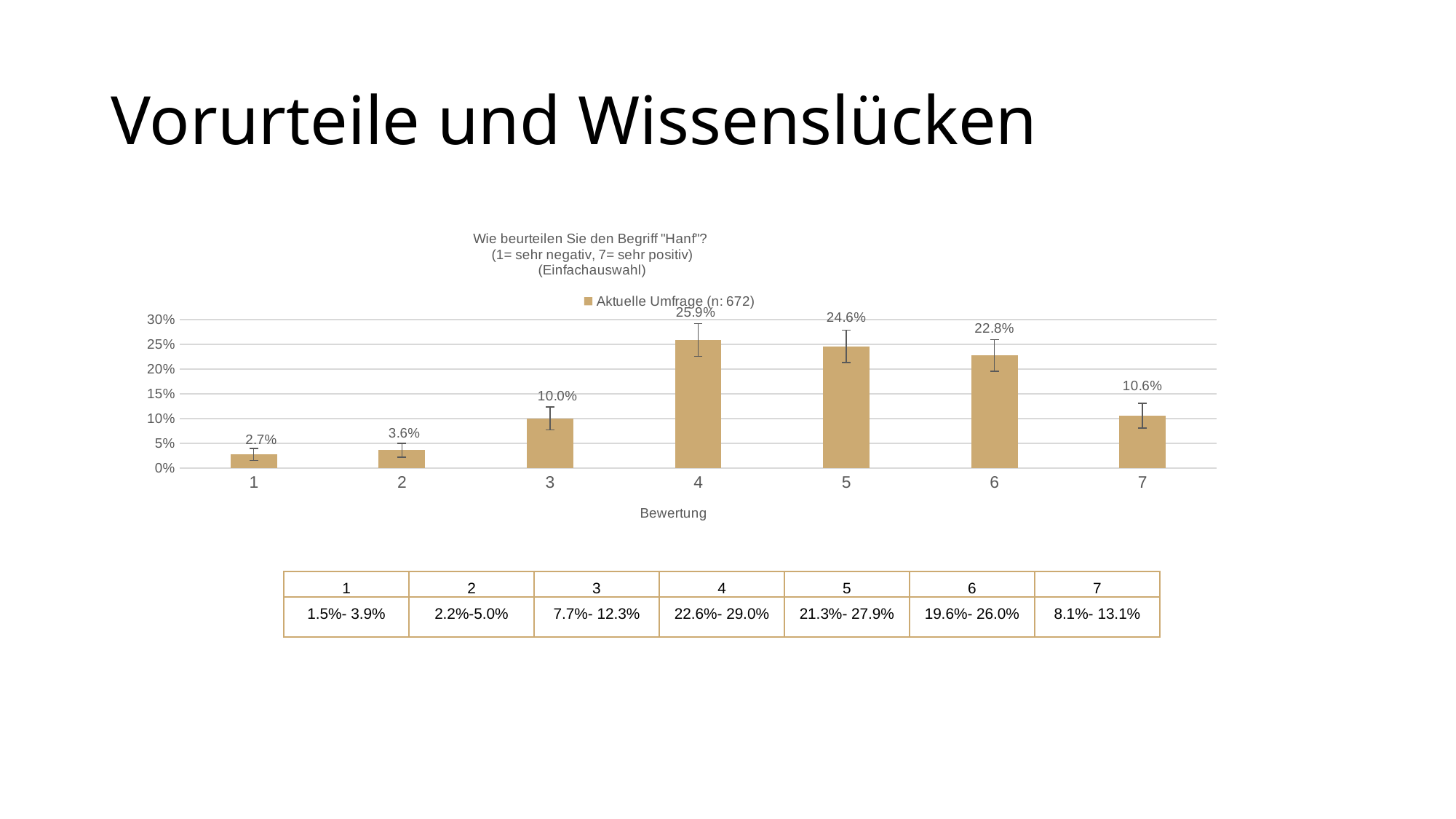
What is the value for rating 1? 2.7% Which rating has the highest value? 4 How many rating categories are shown on the x axis? 7 Which is larger, the value for rating 6 or the value for rating 7? 6 What is the value for rating 7? 10.6% Is the value for rating 5 greater or less than 20%? greater What is the value for rating 4? 25.9% What series does the legend list? Aktuelle Umfrage (n: 672) What is the difference between the values for rating 3 and rating 2? 6.4% Which rating has the lowest value? 1 What is the difference between the values for rating 4 and rating 5? 1.3% What kind of chart is shown? bar chart